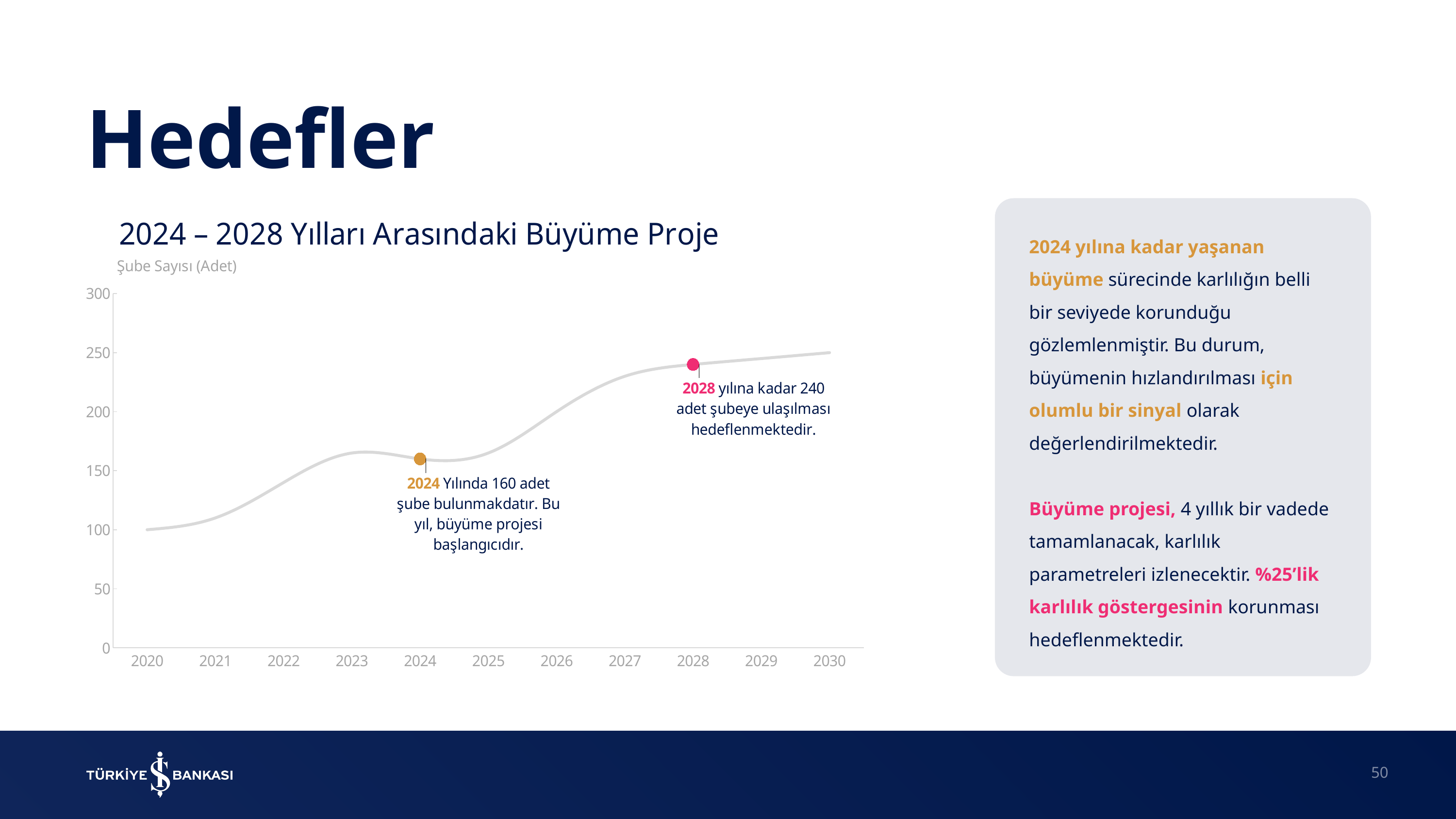
How many years are labelled on the x axis? 11 Which year has the larger value, 2024 or 2028? 2028 What is the number of branches (Şube Sayısı) shown for 2024? 160 Do the values generally rise or fall from 2020 to 2030? rise What is the difference between the 2028 target and the 2024 value? 80 Which year has the lowest value on the chart? 2020 What kind of chart is shown on the slide? line chart What is the targeted number of branches for 2028? 240 Is the value for 2020 greater or less than 150? less What is the title of the chart? 2024 – 2028 Yılları Arasındaki Büyüme Proje Is the value for 2030 greater or less than 200? greater What is the y-axis label of the chart? Şube Sayısı (Adet)